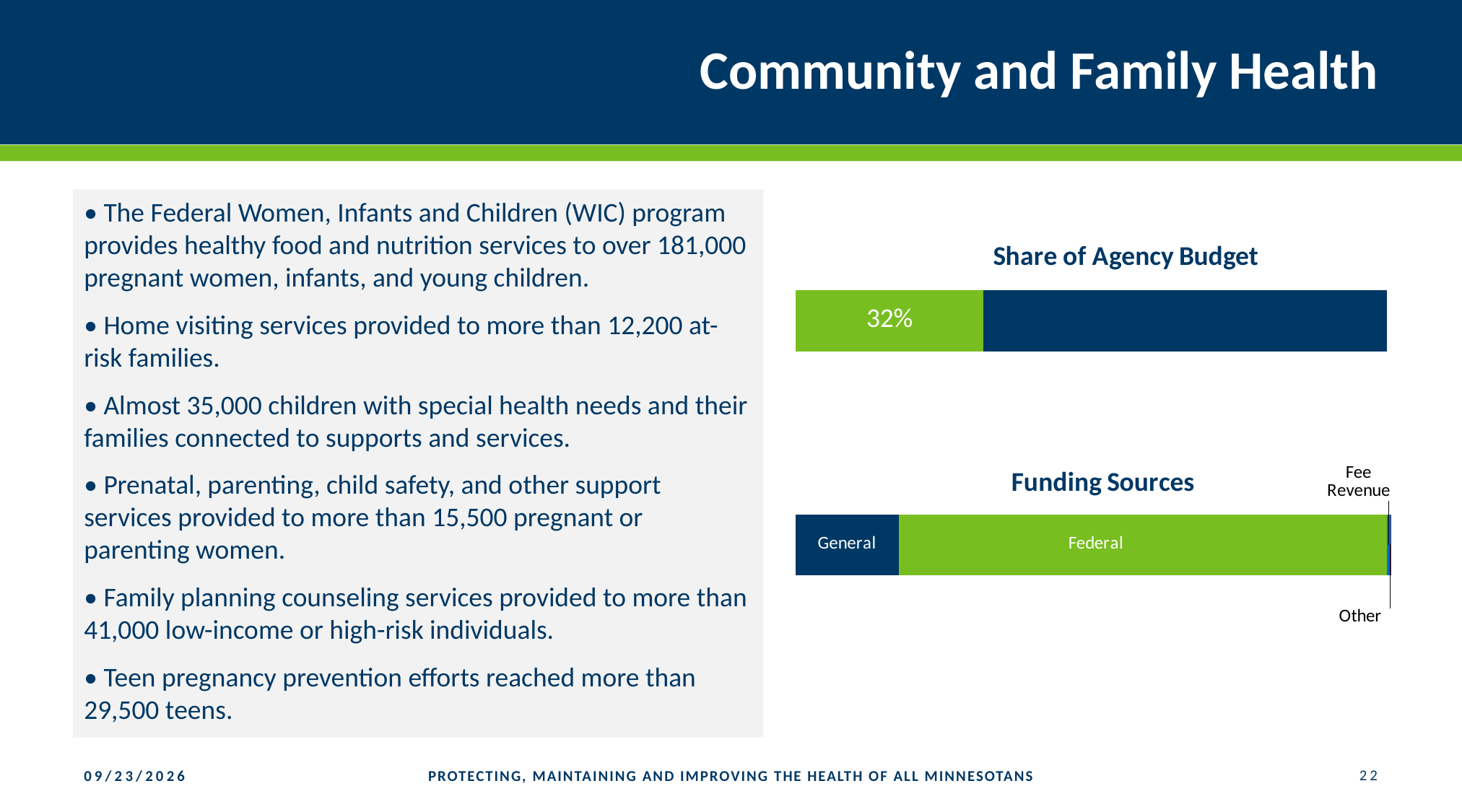
In the Share of Agency Budget chart, what percentage is printed on the green segment? 32% What kind of chart is the Funding Sources chart? bar chart In the Funding Sources chart, which funding source is the largest? Federal In the Share of Agency Budget chart, which segment is larger, the green one or the dark blue one? the dark blue one What is the title of the upper chart on the slide? Share of Agency Budget In the Funding Sources chart, what colour is the Federal segment? green In the Funding Sources chart, which is larger, Federal or Fee Revenue? Federal What kind of chart is the Share of Agency Budget chart? bar chart In the Funding Sources chart, which is larger, General or Federal? Federal In the Funding Sources chart, how many funding source categories are labeled? 4